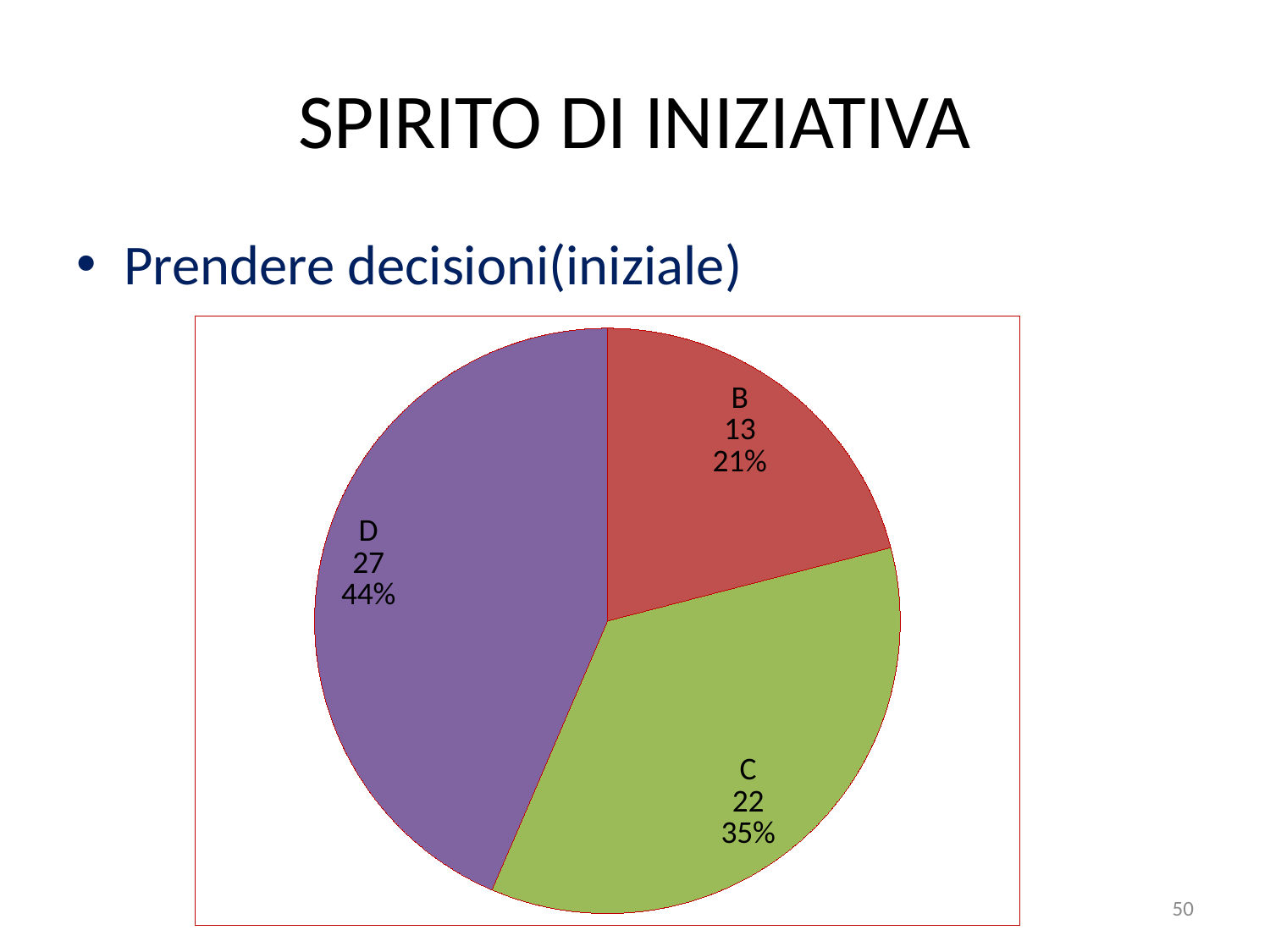
Which slice is the smallest? B What share of the pie does slice B represent? 21% What kind of chart is shown on the slide? pie chart What share of the pie does slice D represent? 44% How many slices does the pie chart have? 3 What is the total of the three slice values? 62 What is the value for slice D? 27 Which is larger, slice C or slice B? C What is the value for slice B? 13 What is the difference between the values of slices D and B? 14 What is the value for slice C? 22 Which slice is the largest? D